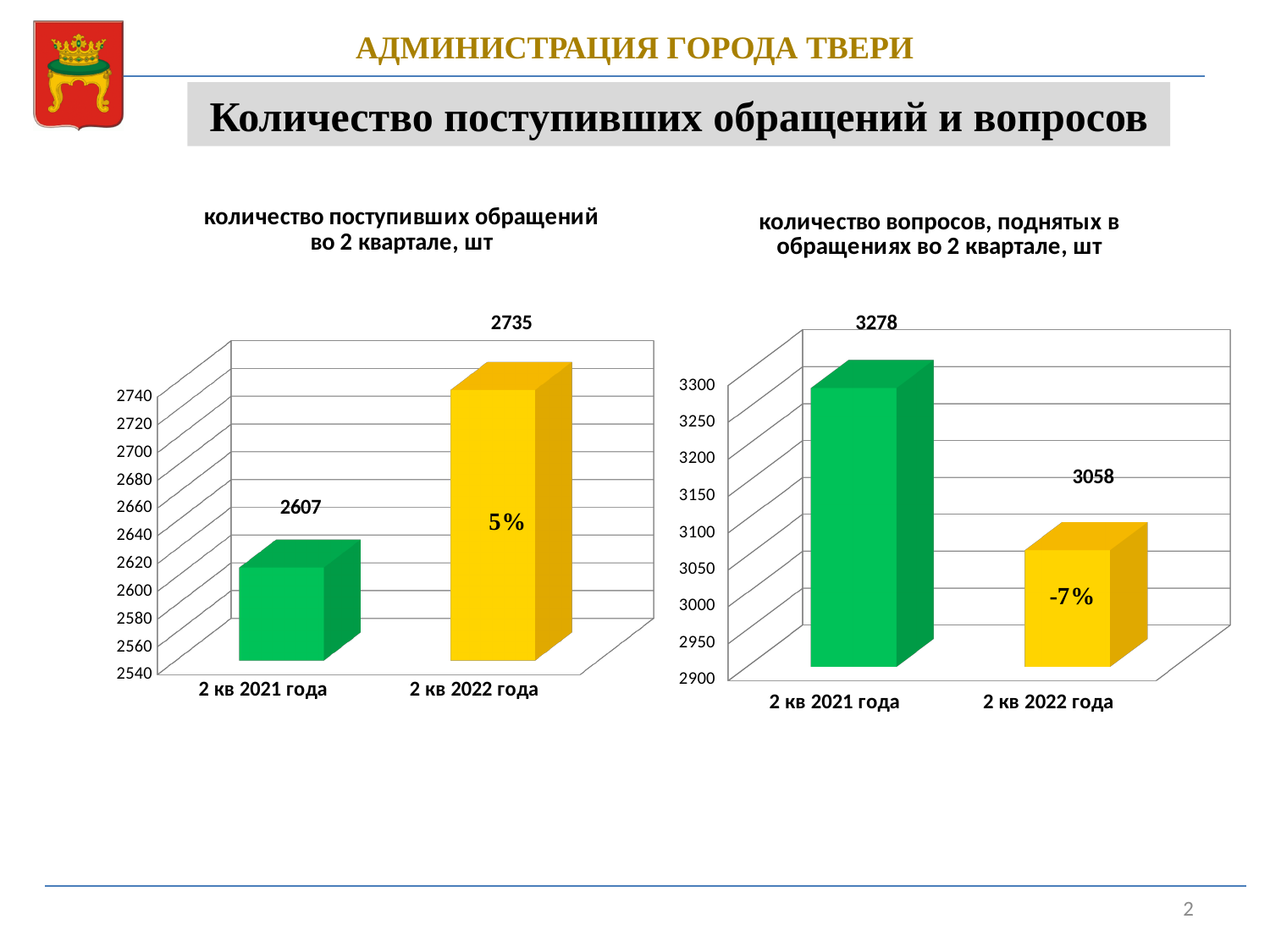
In the right chart, do the values rise or fall from 2 кв 2021 года to 2 кв 2022 года? fall In the left chart (количество поступивших обращений во 2 квартале, шт), what is the value for 2 кв 2022 года? 2735 In the right chart, which category has the lowest value? 2 кв 2022 года In the right chart, what is the difference between the values for 2 кв 2021 года and 2 кв 2022 года? 220 In the right chart, which is larger: the value for 2 кв 2021 года or 2 кв 2022 года? 2 кв 2021 года In the left chart, which category has the highest value? 2 кв 2022 года How many categories does the left chart show? 2 What kind of chart is the right chart? bar chart In the left chart, what is the difference between the values for 2 кв 2022 года and 2 кв 2021 года? 128 In the left chart (количество поступивших обращений во 2 квартале, шт), what is the value for 2 кв 2021 года? 2607 In the right chart (количество вопросов, поднятых в обращениях во 2 квартале, шт), what is the value for 2 кв 2022 года? 3058 In the right chart (количество вопросов, поднятых в обращениях во 2 квартале, шт), what is the value for 2 кв 2021 года? 3278